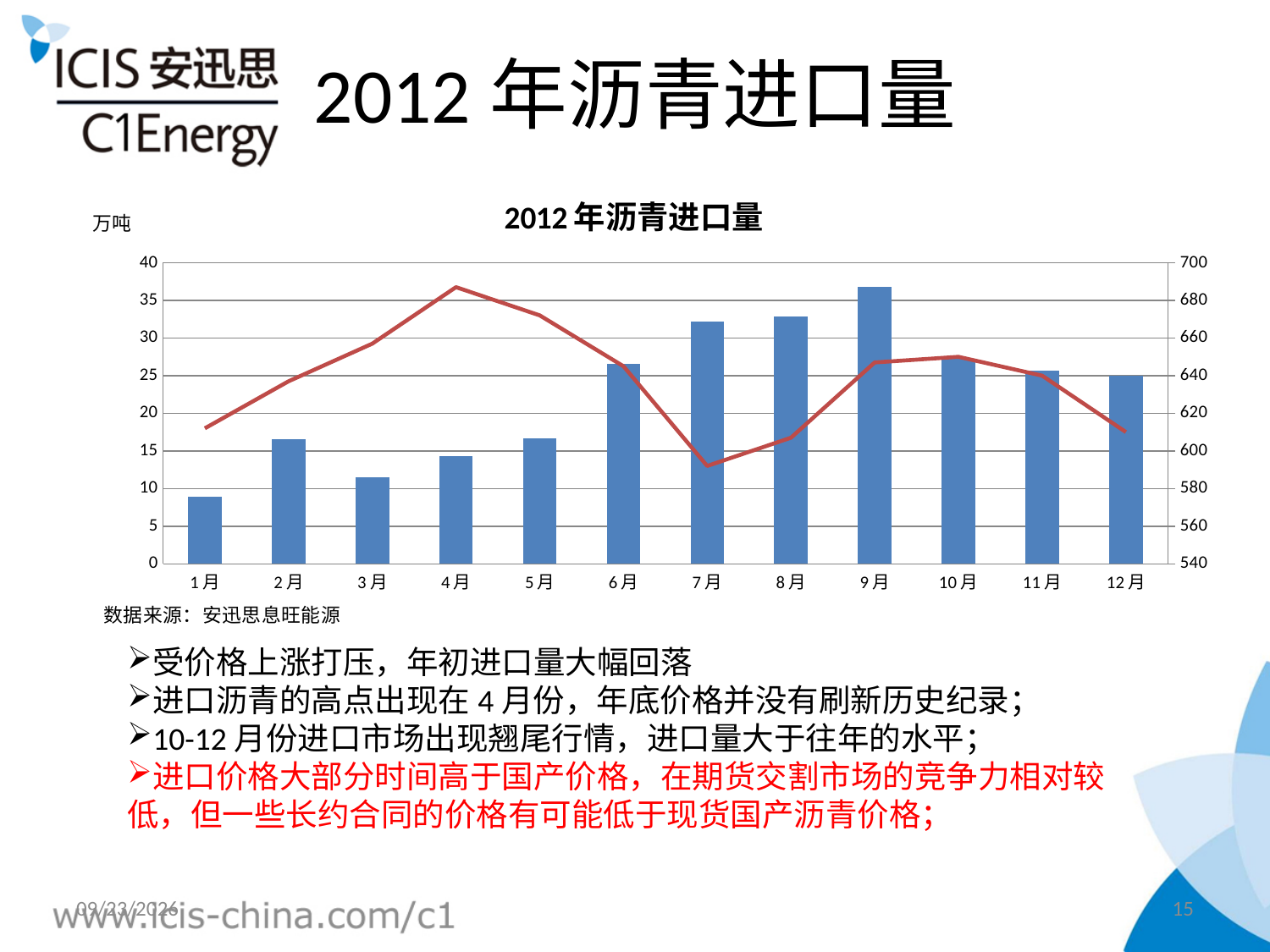
How many months (categories) are plotted on the x axis? 12 Is the bar value for 1月 greater or less than 10? less Is the bar value for 9月 greater or less than 35? greater What kind of chart is shown on the slide? bar chart with a line Is the bar value for 7月 greater or less than 30? greater In which month does the red line reach its lowest point? 7月 In which month does the red line reach its highest point? 4月 Which bar is taller, 2月 or 3月? 2月 Which month has the shortest bar? 1月 What is the title of the chart? 2012 年沥青进口量 Which month has the tallest bar? 9月